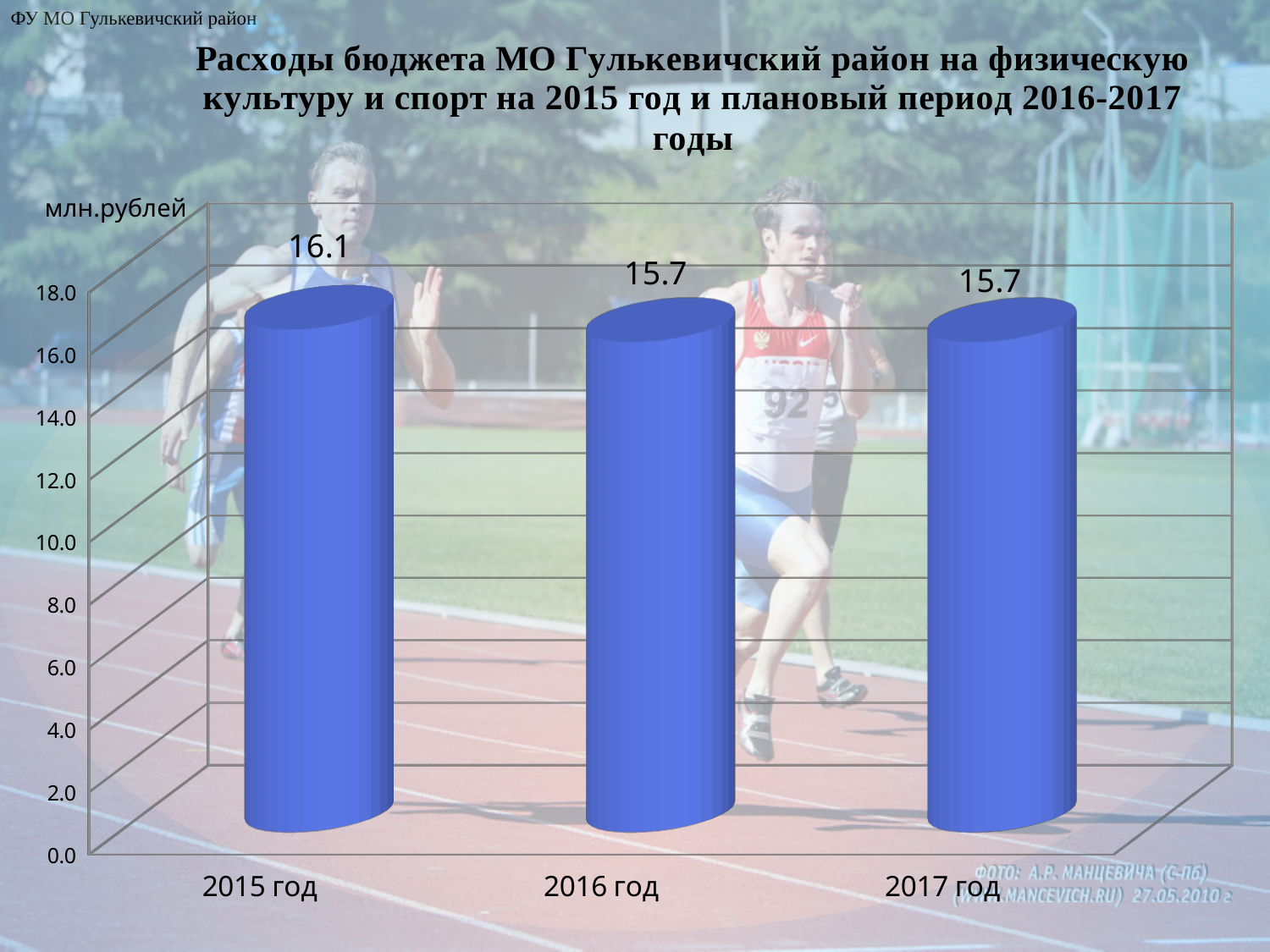
What is the value for 2015 год? 16.1 Which year has the highest value? 2015 год Is the value for 2016 год greater or less than 14.0? greater What unit is shown on the chart's axis label? млн.рублей What kind of chart is shown on the slide? bar chart Do the values rise or fall from 2015 год to 2016 год? fall What is the maximum value shown on the vertical axis? 18.0 What is the value for 2016 год? 15.7 What is the difference between the values for 2015 год and 2016 год? 0.4 What is the value for 2017 год? 15.7 Which is larger, the value for 2015 год or the value for 2017 год? 2015 год How many years are shown on the chart? 3